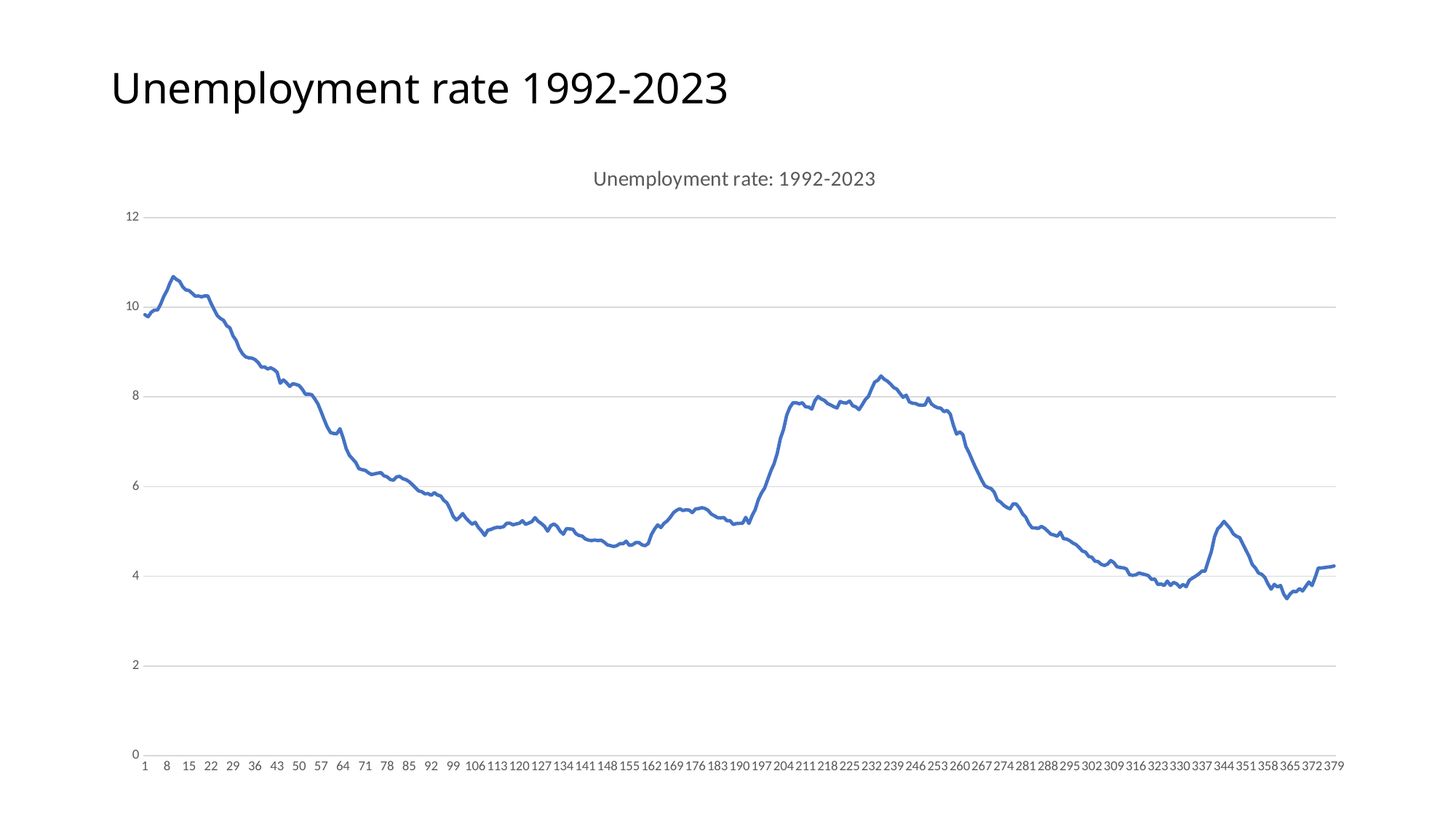
Is the value at point 1 greater or less than 8? greater Is the value at point 106 greater or less than 6? less Which is larger, the value at point 1 or the value at point 379? point 1 What is the highest value shown on the vertical axis? 12 Is the value at point 211 greater or less than 6? greater What kind of chart is shown on the slide? line chart Do the values rise or fall between point 197 and point 211? rise Which is larger, the value at point 239 or the value at point 344? point 239 What is the title of the chart? Unemployment rate: 1992-2023 Do the values rise or fall between point 1 and point 106? fall